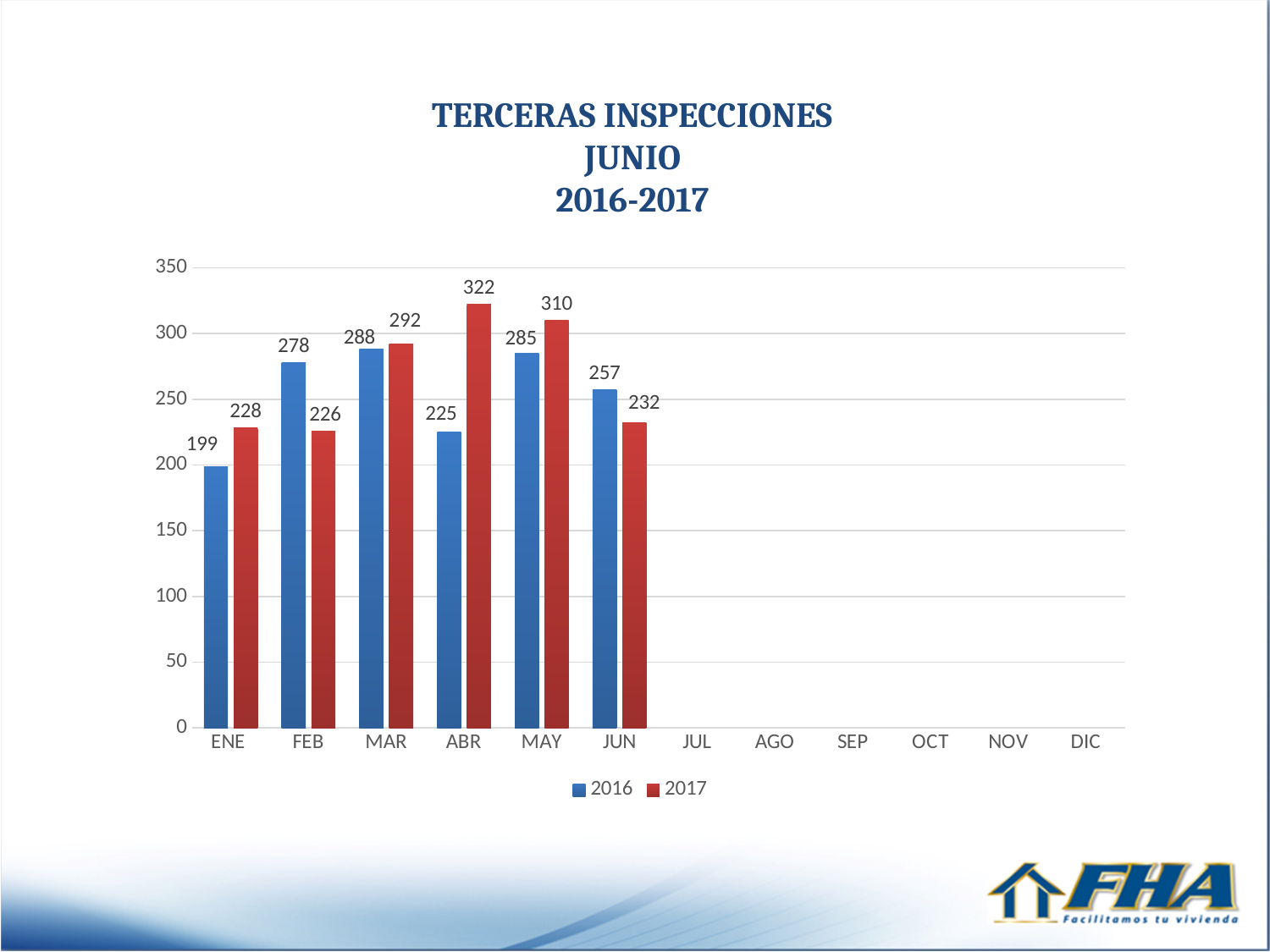
What is the title of the chart? TERCERAS INSPECCIONES JUNIO 2016-2017 What kind of chart is shown on the slide? bar chart What is the value for 2017 in ABR? 322 What is the difference between the 2017 and 2016 values in ABR? 97 What is the value for 2016 in ENE? 199 How many series does the legend list? 2 Which month has the highest value for the 2017 series? ABR Which is larger in FEB, the 2016 value or the 2017 value? 2016 What is the value for 2016 in JUN? 257 Which month has the lowest value for the 2016 series? ENE How many months are labelled on the x axis? 12 Is the value for 2017 in MAY greater or less than 300? greater